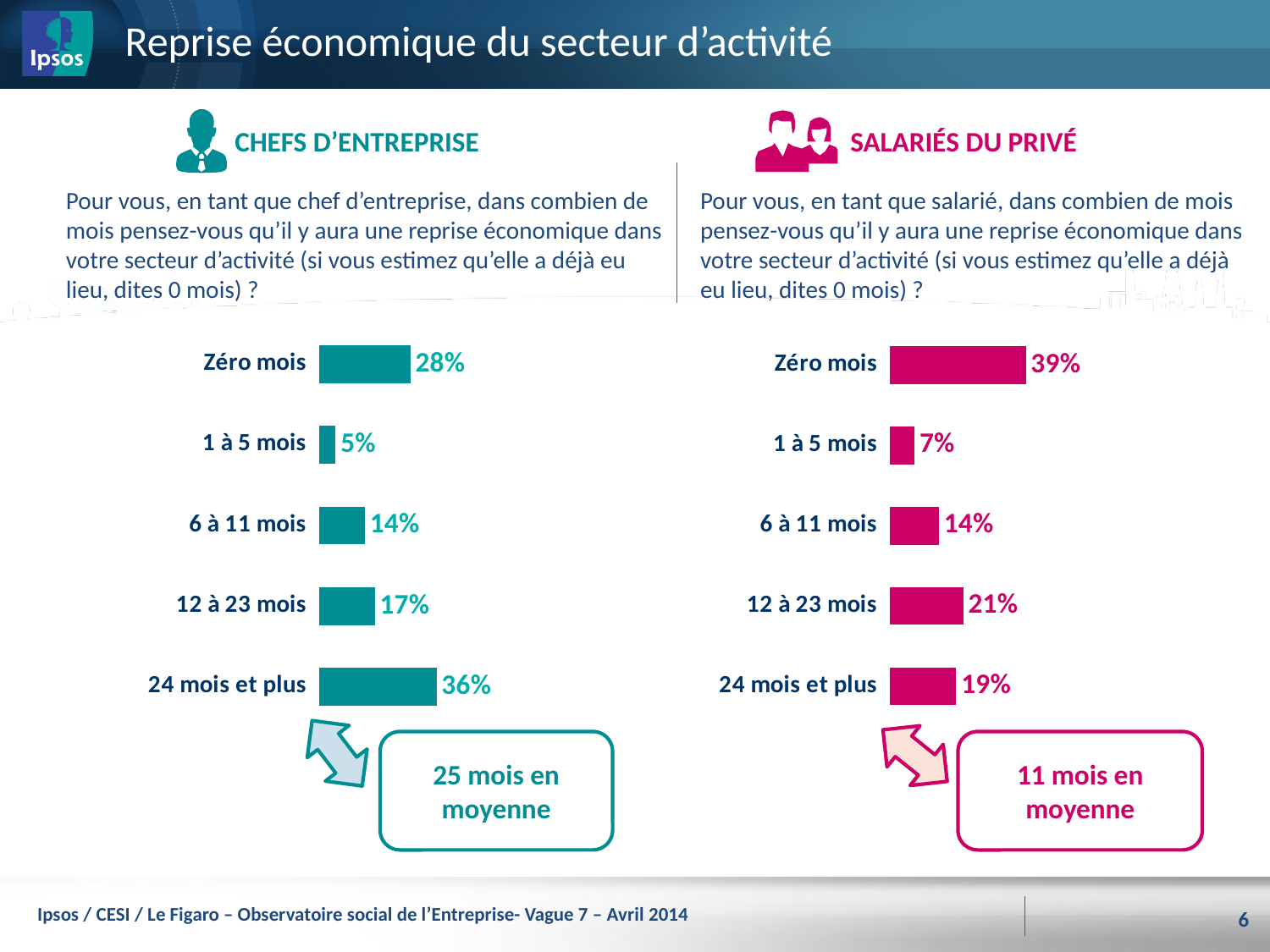
How many categories does the Chefs d'entreprise chart on the left show? 5 What colour are the bars in the Chefs d'entreprise chart on the left? Teal In the Chefs d'entreprise chart on the left, what is the value for "1 à 5 mois"? 5% In the Chefs d'entreprise chart on the left, which category has the highest value? 24 mois et plus In the Salariés du privé chart on the right, which category has the lowest value? 1 à 5 mois In the Chefs d'entreprise chart on the left, what is the difference between "Zéro mois" and "12 à 23 mois"? 11 percentage points In the Chefs d'entreprise chart on the left, what is the value for "24 mois et plus"? 36% What kind of chart is used on the left for Chefs d'entreprise? Bar chart What average number of months is shown in the box below the Salariés du privé chart on the right? 11 mois en moyenne In the Salariés du privé chart on the right, which is larger: "12 à 23 mois" or "24 mois et plus"? 12 à 23 mois In the Salariés du privé chart on the right, what is the value for "6 à 11 mois"? 14% In the Salariés du privé chart on the right, what is the value for "Zéro mois"? 39%